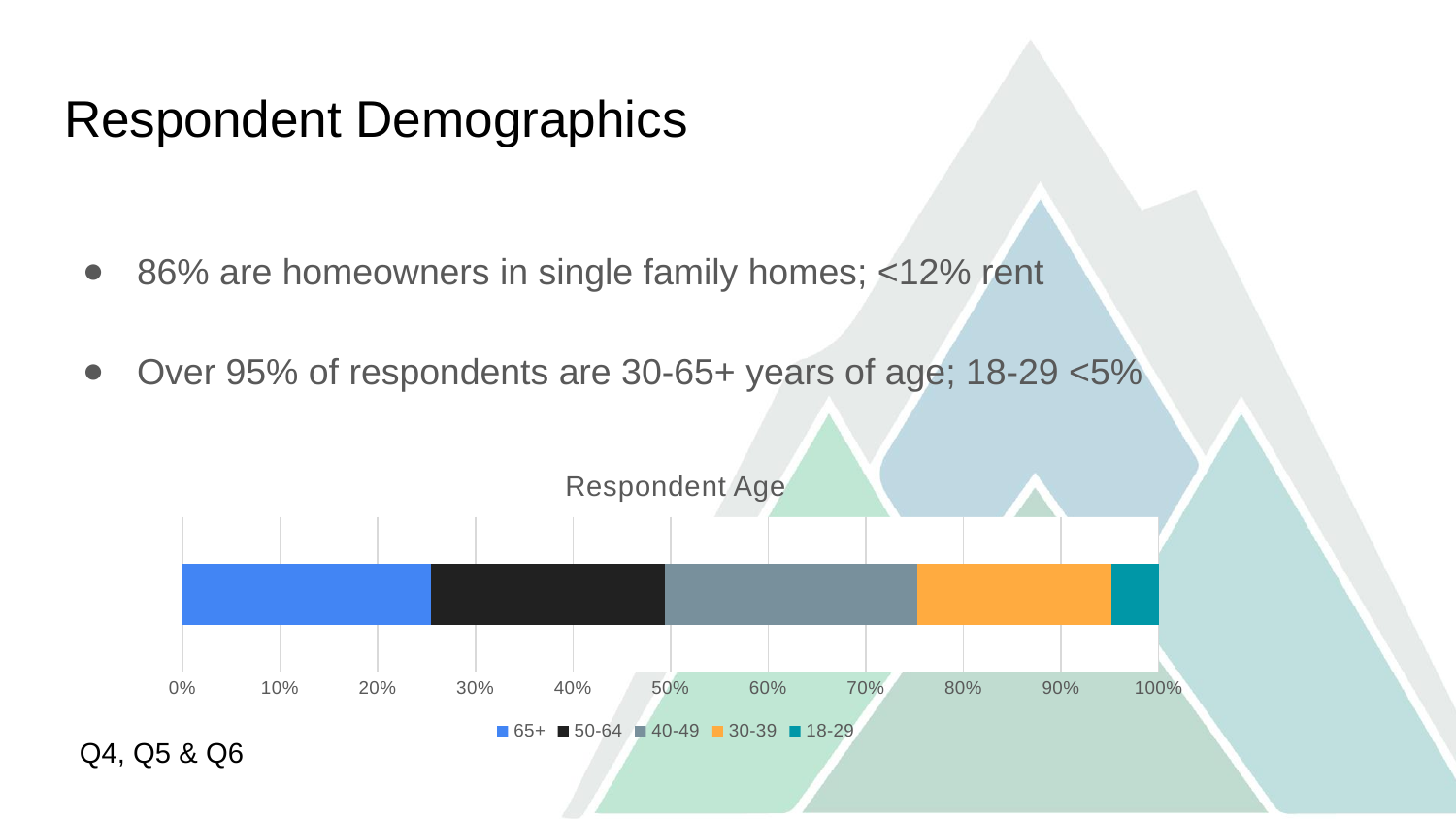
Is the share for the 40-49 age group greater or less than 20%? greater Which age group has the smallest share of the Respondent Age bar? 18-29 Is the share for the 65+ age group greater or less than 20%? greater Which age group takes up a larger share of the bar, 30-39 or 18-29? 30-39 Which age group is shown in orange in the chart? 30-39 Is the share for the 30-39 age group greater or less than 10%? greater What is the highest value shown on the chart's horizontal axis? 100% What is the title of the chart? Respondent Age Which age group takes up a larger share of the bar, 40-49 or 18-29? 40-49 How many series does the chart's legend list? 5 What kind of chart is shown on the slide? Stacked bar chart